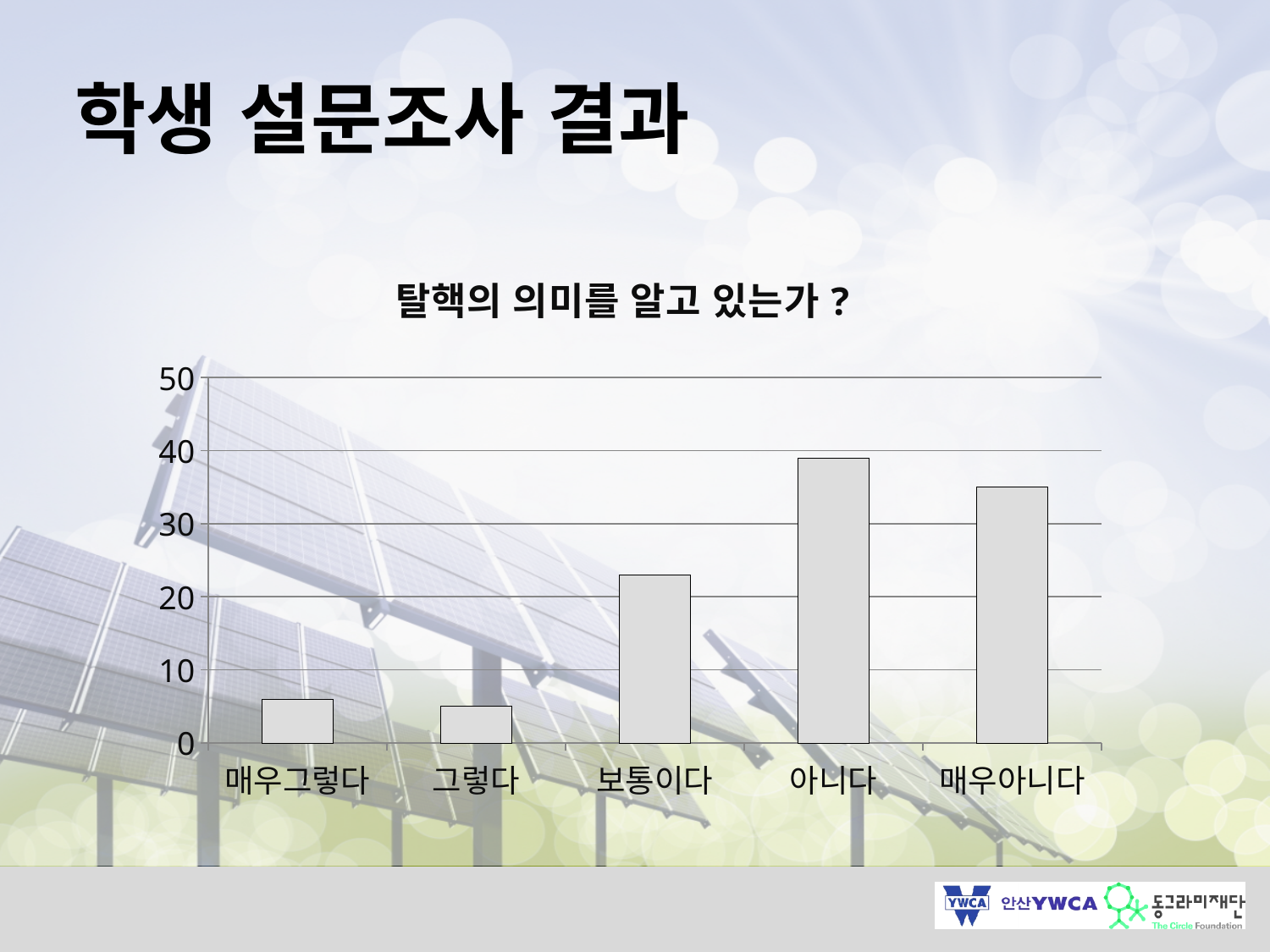
How many categories are shown on the x axis of the chart? 5 Which is larger, the value for 보통이다 or the value for 그렇다? 보통이다 Which is larger, the value for 아니다 or the value for 매우아니다? 아니다 Which category has the highest bar in the chart? 아니다 Is the value for 보통이다 greater or less than 20? greater What kind of chart is shown on the slide? bar chart Is the value for 매우그렇다 greater or less than 10? less Is the value for 아니다 greater or less than 30? greater What is the title of the chart? 탈핵의 의미를 알고 있는가 ?